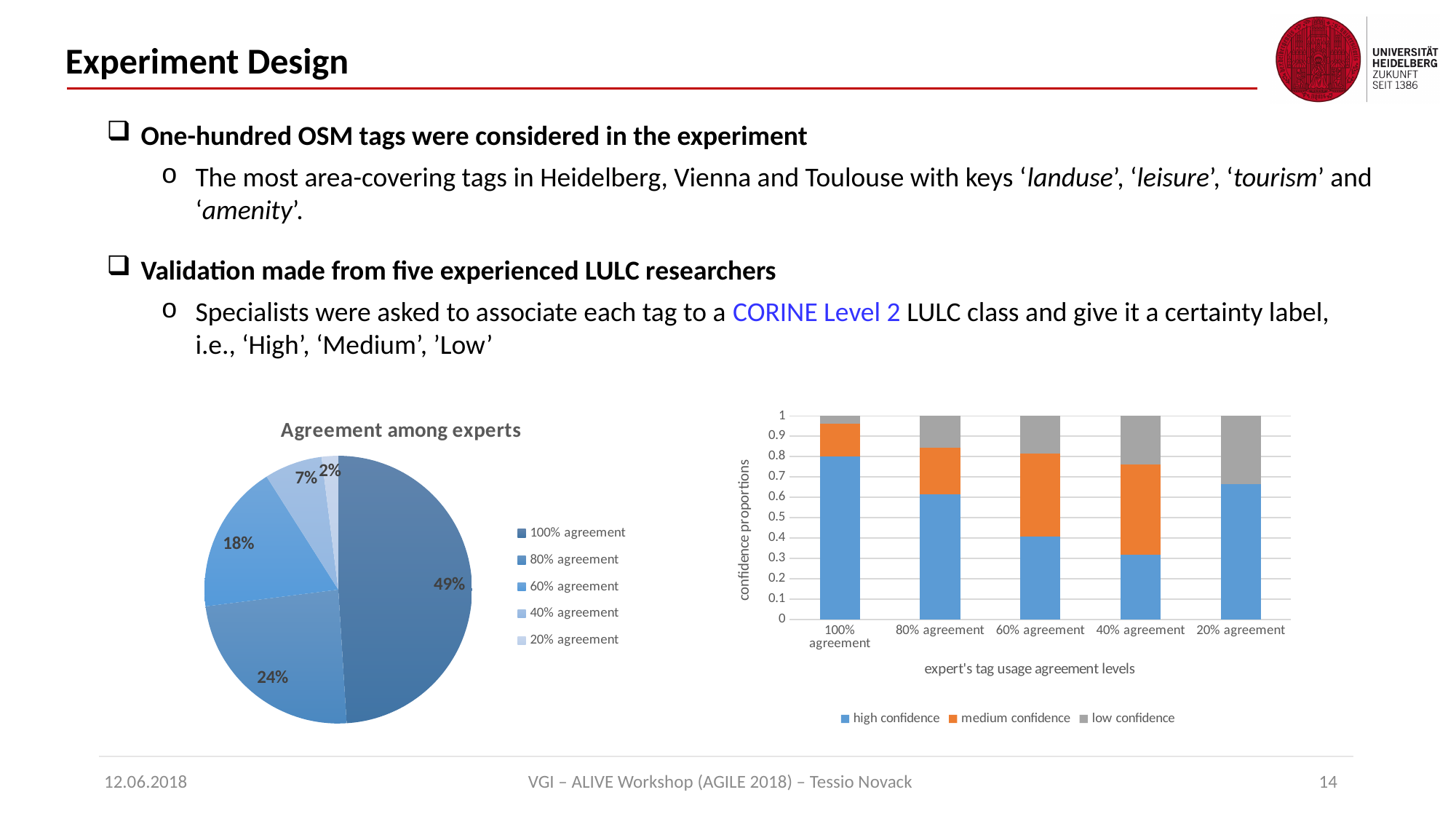
In the 'Agreement among experts' pie chart, what share is labelled for 100% agreement? 49% In the 'Agreement among experts' pie chart, what is the difference between the 80% agreement and 60% agreement shares? 6% In the 'Agreement among experts' pie chart, what share is labelled for 20% agreement? 2% In the 'Agreement among experts' pie chart, which category has the smallest slice? 20% agreement What kind of chart is the chart on the right of the slide? Stacked bar chart How many categories does the 'Agreement among experts' pie chart legend list? 5 In the stacked bar chart on the right, is the high confidence proportion for 40% agreement greater or less than 0.5? less In the stacked bar chart on the right, is the high confidence proportion for 100% agreement greater or less than 0.7? greater In the 'Agreement among experts' pie chart, which category has the largest slice? 100% agreement How many series does the legend of the stacked bar chart on the right list? 3 In the 'Agreement among experts' pie chart, what share is labelled for 80% agreement? 24% In the stacked bar chart on the right, which agreement level has the highest high confidence proportion? 100% agreement